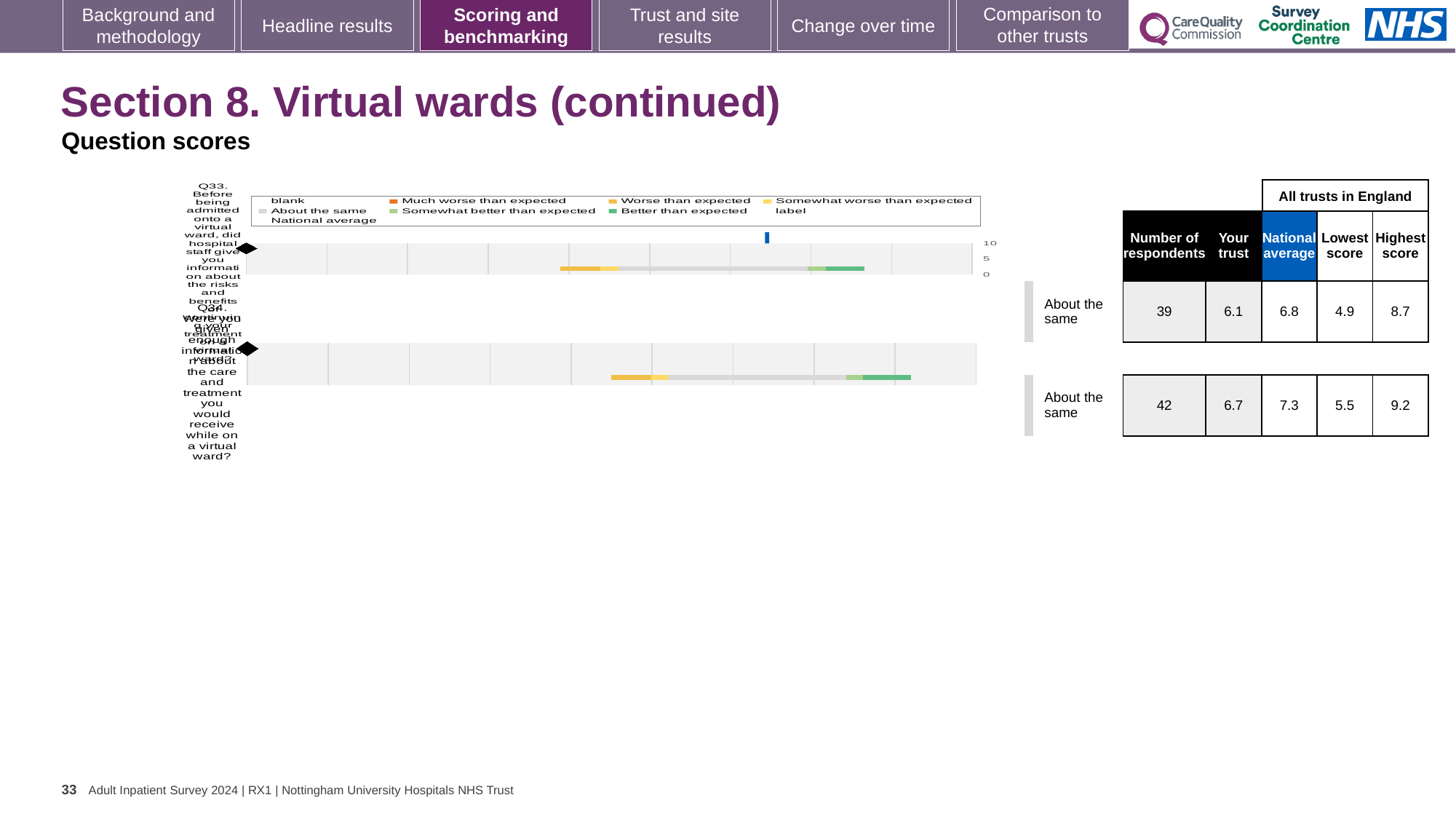
What is the difference between the highest and lowest scores for Q34? 3.7 How many questions (categories) are plotted in the chart? 2 How many respondents answered Q33? 39 What is the 'Your trust' score for Q33? 6.1 What is the lowest score among all trusts in England for Q34? 5.5 What kind of chart is shown on the slide? bar chart Which question has the higher number of respondents? Q34 What is the highest score among all trusts in England for Q33? 8.7 What benchmark category is shown for both Q33 and Q34? About the same What is the national average score for Q34? 7.3 Which question has the higher 'Your trust' score, Q33 or Q34? Q34 What is the difference between the national average and the 'Your trust' score for Q33? 0.7